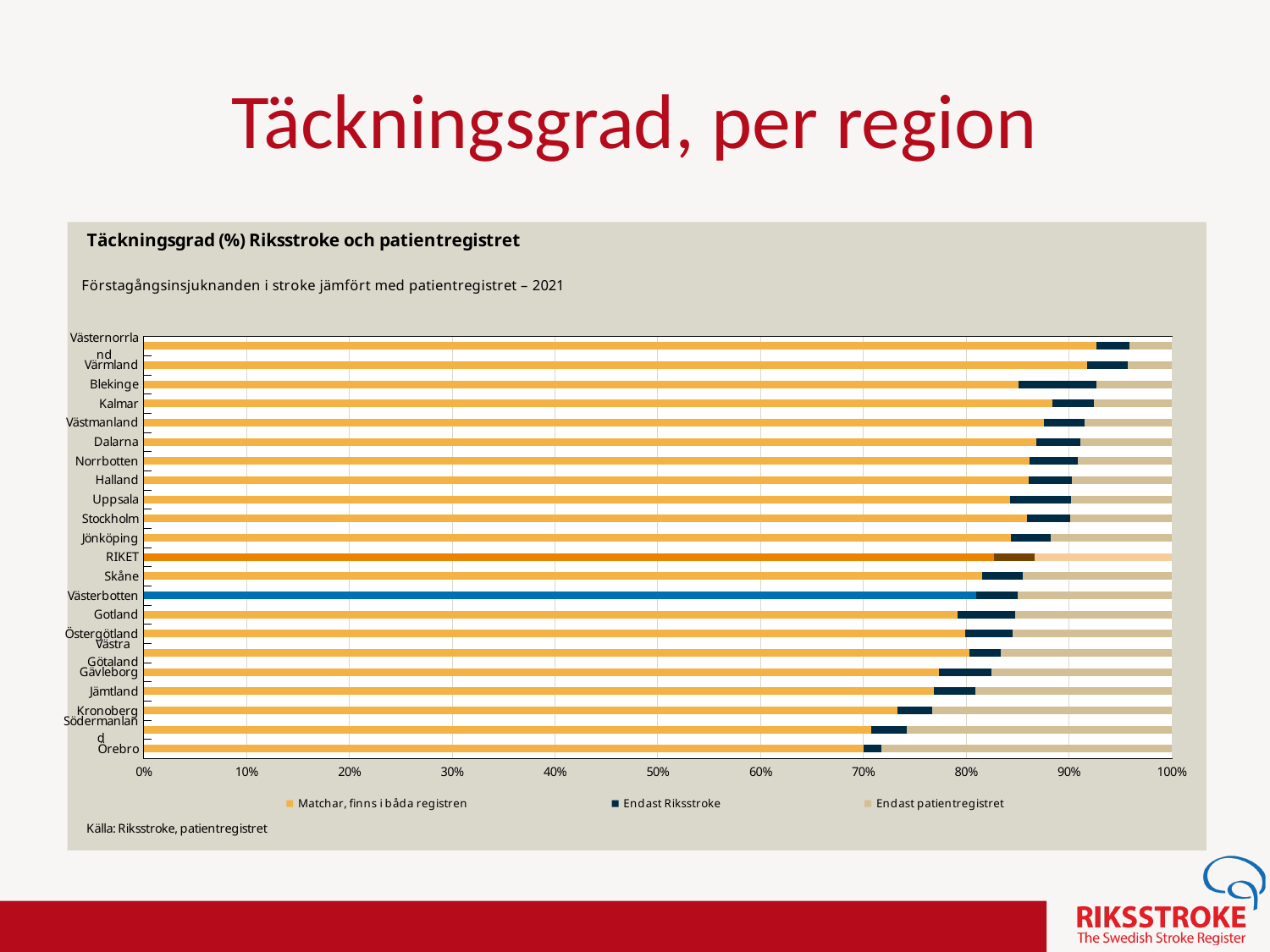
Which has the larger 'Matchar, finns i båda registren' share, Blekinge or Örebro? Blekinge What source is cited below the chart? Källa: Riksstroke, patientregistret Which region has the smallest 'Matchar, finns i båda registren' share? Örebro Is the 'Matchar, finns i båda registren' value for Kronoberg greater or less than 80%? less What is the title of the chart? Täckningsgrad (%) Riksstroke och patientregistret Which region has the largest 'Matchar, finns i båda registren' share? Västernorrland How many series does the legend list? 3 Is the 'Matchar, finns i båda registren' value for Västernorrland greater or less than 90%? greater What kind of chart is shown on the slide? Bar chart How many regions (categories) are plotted on the chart, including RIKET? 22 Is the 'Matchar, finns i båda registren' value for Örebro greater or less than 80%? less